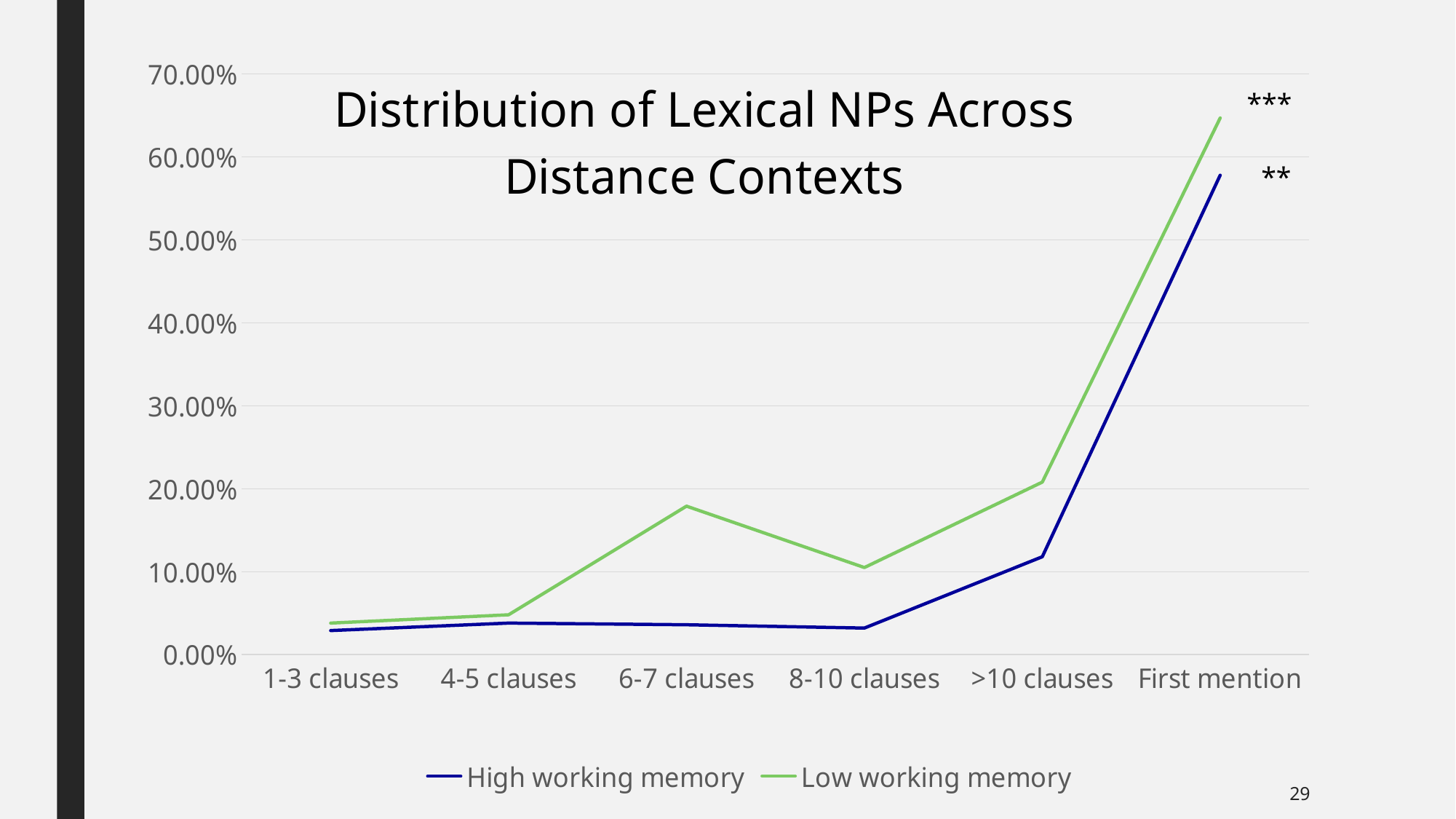
Is the value for High working memory at First mention greater or less than 50%? greater How many distance categories are shown on the x axis? 6 Is the value for Low working memory at 6-7 clauses greater or less than 10%? greater Is the value for High working memory at >10 clauses greater or less than 20%? less At 6-7 clauses, which series has the higher value, High working memory or Low working memory? Low working memory Which category has the highest value for Low working memory? First mention How many series does the legend list? 2 What is the title of the chart? Distribution of Lexical NPs Across Distance Contexts What type of chart is shown on the slide? line chart Which category has the highest value for High working memory? First mention